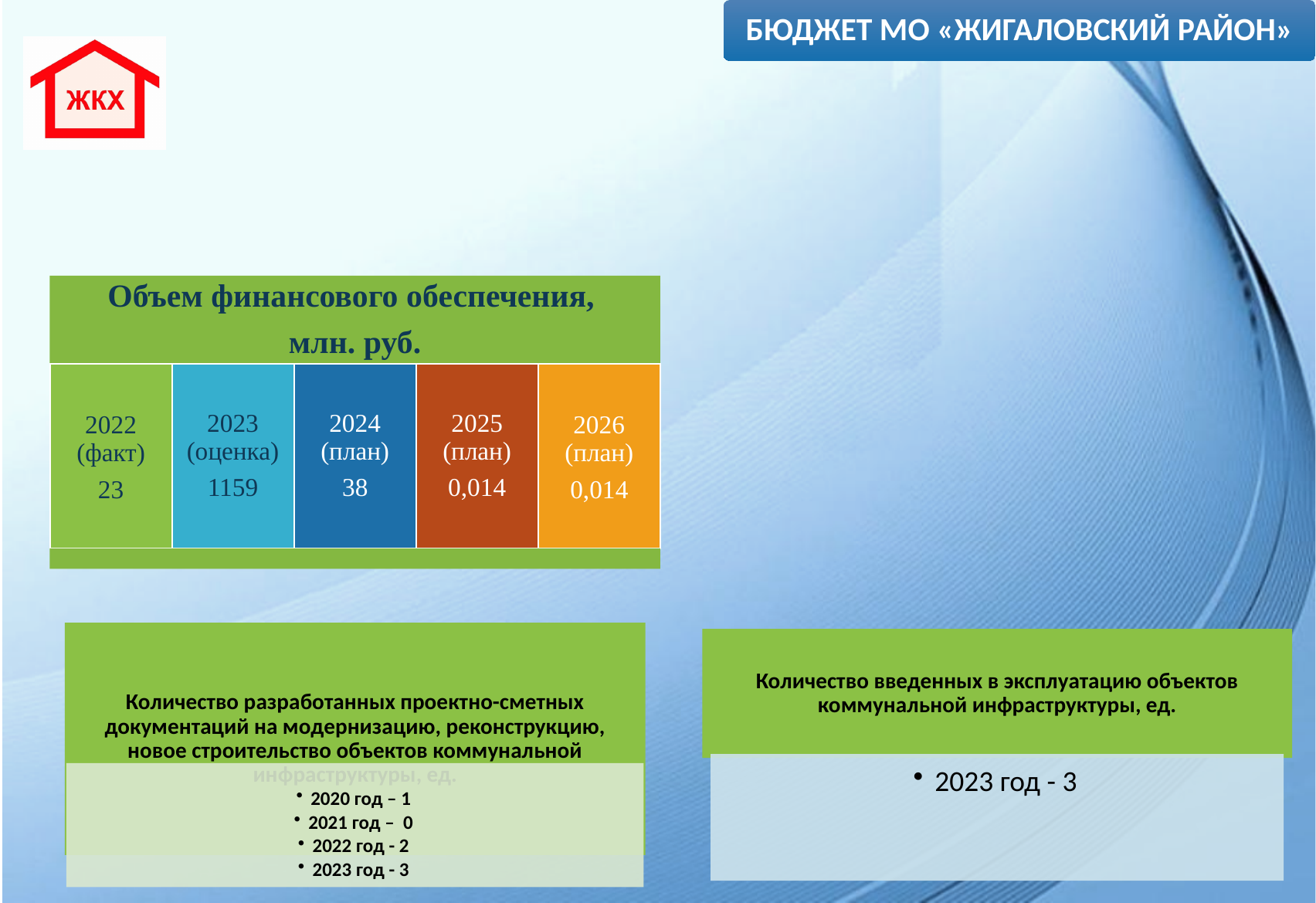
What is the value for 2023 (оценка) in the 'Объем финансового обеспечения, млн. руб.' chart? 1159 What colour is the block for 2025 (план) in the 'Объем финансового обеспечения, млн. руб.' chart? Brown (dark orange) In the 'Объем финансового обеспечения, млн. руб.' chart, which is larger: the value for 2022 (факт) or the value for 2024 (план)? 2024 (план) What is the title of the chart on the left side of the slide? Объем финансового обеспечения, млн. руб. What is the value for 2024 (план) in the 'Объем финансового обеспечения, млн. руб.' chart? 38 What is the value for 2025 (план) in the 'Объем финансового обеспечения, млн. руб.' chart? 0,014 Which year has the highest value in the 'Объем финансового обеспечения, млн. руб.' chart? 2023 (оценка) How many year categories are shown in the 'Объем финансового обеспечения, млн. руб.' chart? 5 What is the value for 2022 (факт) in the 'Объем финансового обеспечения, млн. руб.' chart? 23 In the 'Объем финансового обеспечения, млн. руб.' chart, what is the difference between the 2023 (оценка) value and the 2024 (план) value? 1121 What is the value for 2026 (план) in the 'Объем финансового обеспечения, млн. руб.' chart? 0,014 In the 'Объем финансового обеспечения, млн. руб.' chart, what is the difference between the 2024 (план) value and the 2022 (факт) value? 15